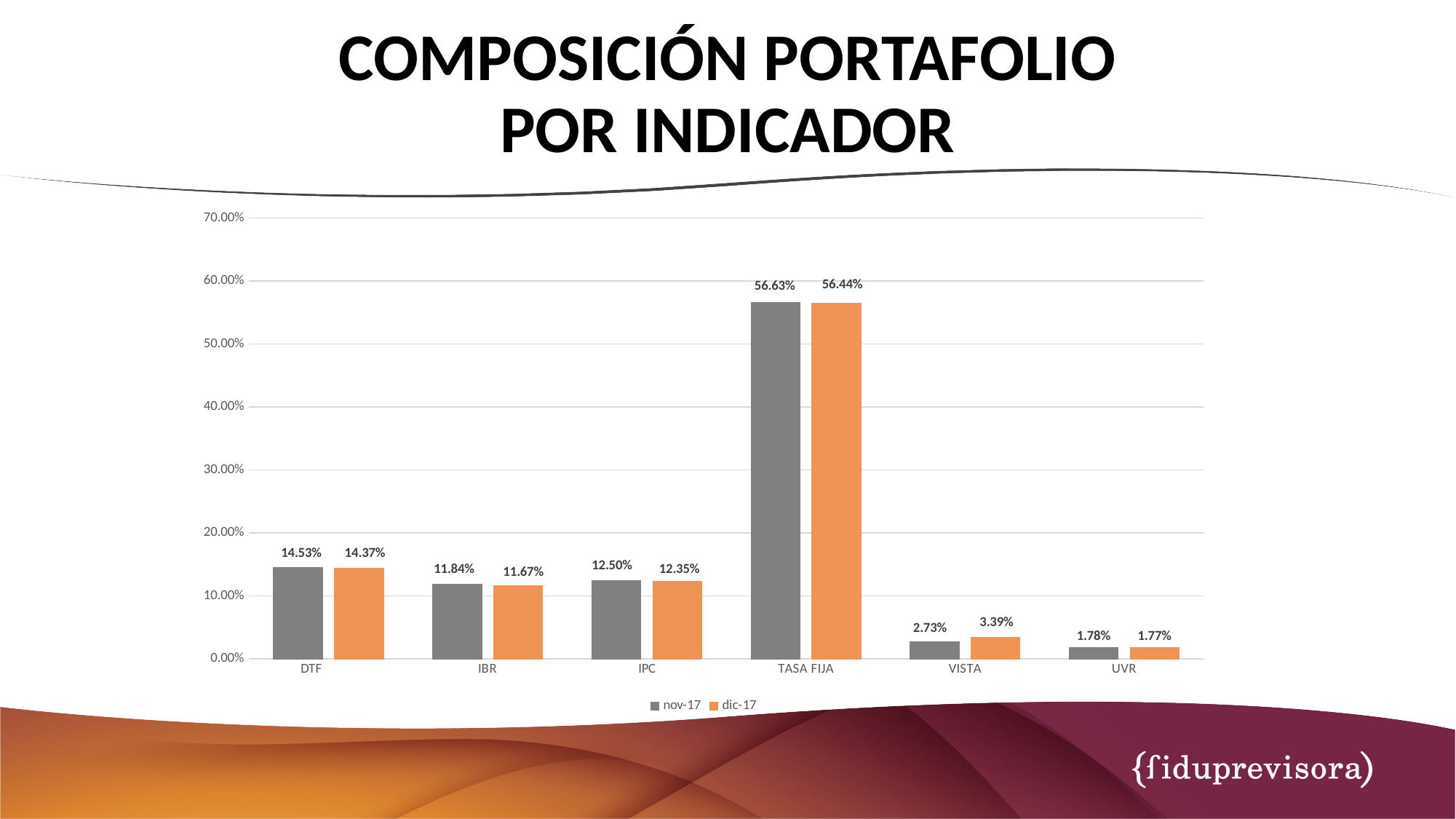
What is the difference between the nov-17 and dic-17 values for DTF? 0.16% What colour are the dic-17 bars? orange How many categories are shown on the x axis? 6 What is the value for VISTA in the dic-17 series? 3.39% How many series does the legend list? 2 What kind of chart is shown on the slide? bar chart Which is larger for VISTA: the nov-17 value or the dic-17 value? dic-17 What is the value for IBR in the dic-17 series? 11.67% Which category has the highest value in the dic-17 series? TASA FIJA Is the nov-17 value for TASA FIJA greater or less than 50.00%? greater Which category has the lowest value in the nov-17 series? UVR What is the value for TASA FIJA in the nov-17 series? 56.63%